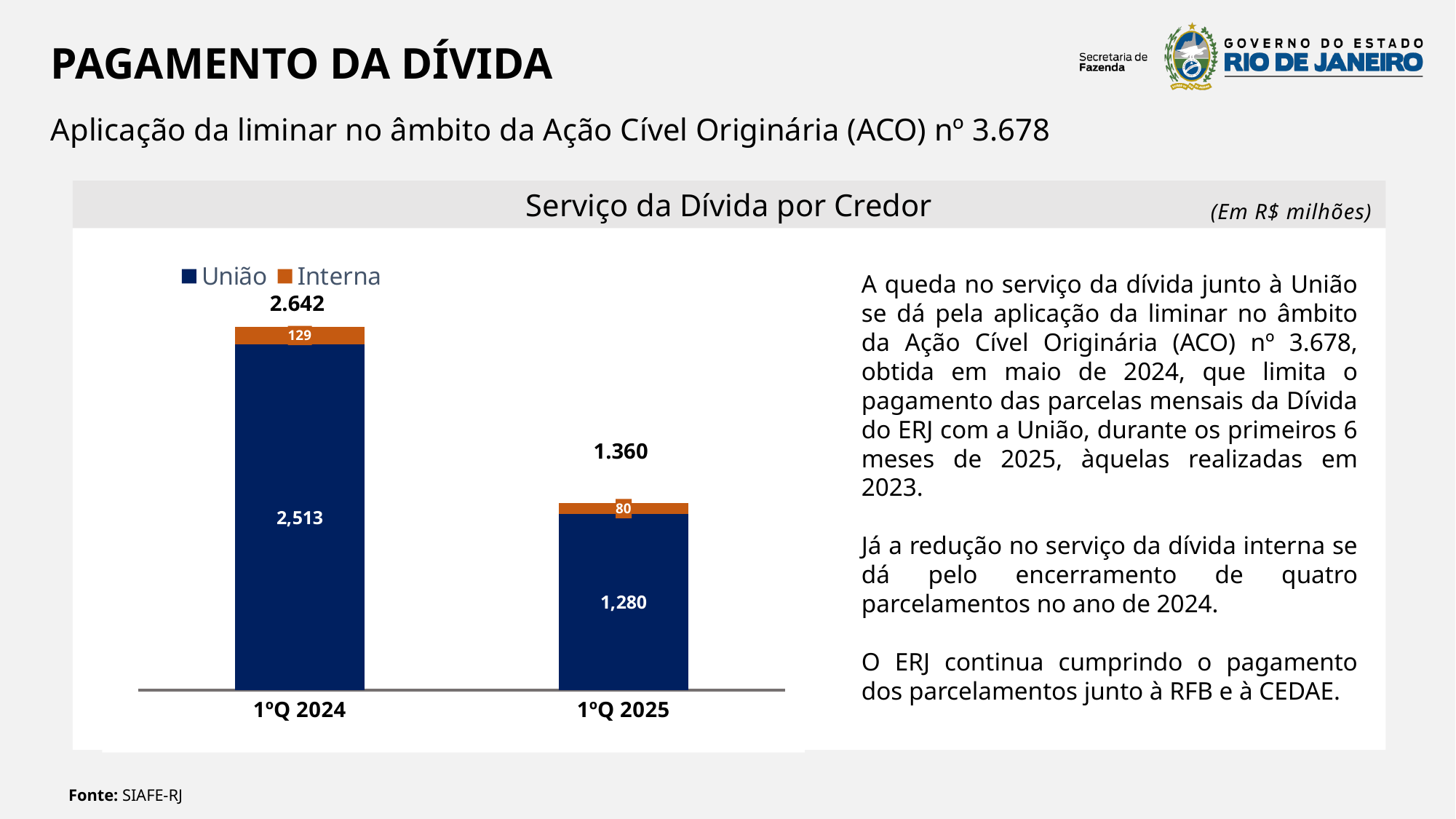
What is the difference between the União values for 1ºQ 2024 and 1ºQ 2025? 1,233 What is the total of the stacked bar for 1ºQ 2024? 2.642 What is the value for Interna in 1ºQ 2025? 80 What type of chart is shown under the title 'Serviço da Dívida por Credor'? Stacked bar chart Which period has the higher total debt service, 1ºQ 2024 or 1ºQ 2025? 1ºQ 2024 What is the difference between the Interna values for 1ºQ 2024 and 1ºQ 2025? 49 How many series does the legend list? 2 In what unit are the chart values expressed? Em R$ milhões What is the total of the stacked bar for 1ºQ 2025? 1.360 What is the value for Interna in 1ºQ 2024? 129 What is the value for União in 1ºQ 2024? 2,513 What is the value for União in 1ºQ 2025? 1,280